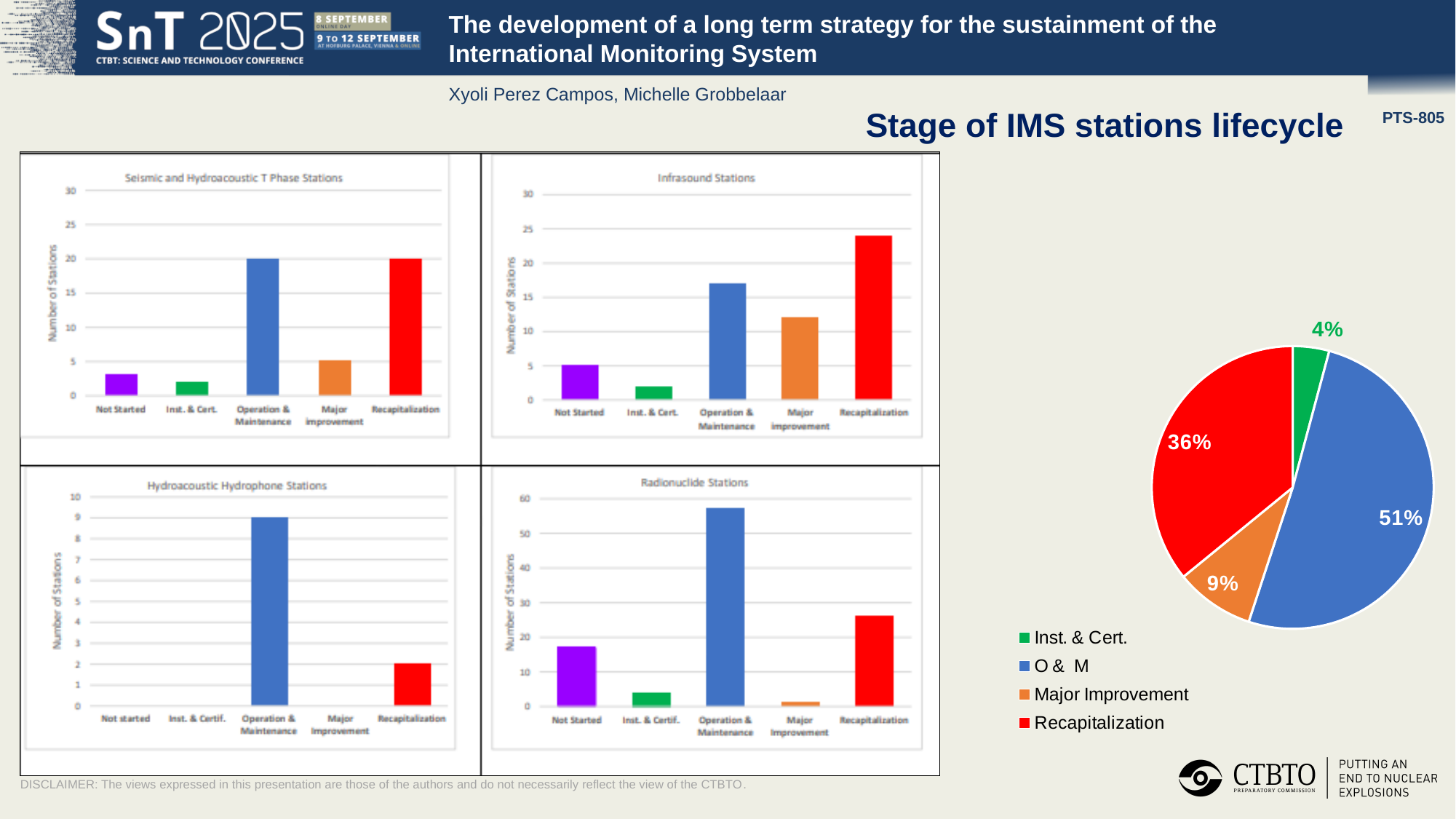
In the Seismic and Hydroacoustic T Phase Stations chart, how many categories are shown on the x axis? 5 In the pie chart, which category has the largest share? O & M In the pie chart, which category has the smallest share? Inst. & Cert. In the pie chart, what share does O & M have? 51% In the Hydroacoustic Hydrophone Stations chart, what is the number of stations in Operation & Maintenance? 9 How many entries does the legend of the pie chart list? 4 In the Infrasound Stations chart, which category has the highest number of stations? Recapitalization In the Hydroacoustic Hydrophone Stations chart, what is the number of stations in Recapitalization? 2 In the pie chart, what is the difference between the O & M share and the Recapitalization share? 15% What kind of chart is the Radionuclide Stations chart? Bar chart In the Radionuclide Stations chart, is the value for Operation & Maintenance greater or less than 50? greater In the pie chart, what share does Recapitalization have? 36%